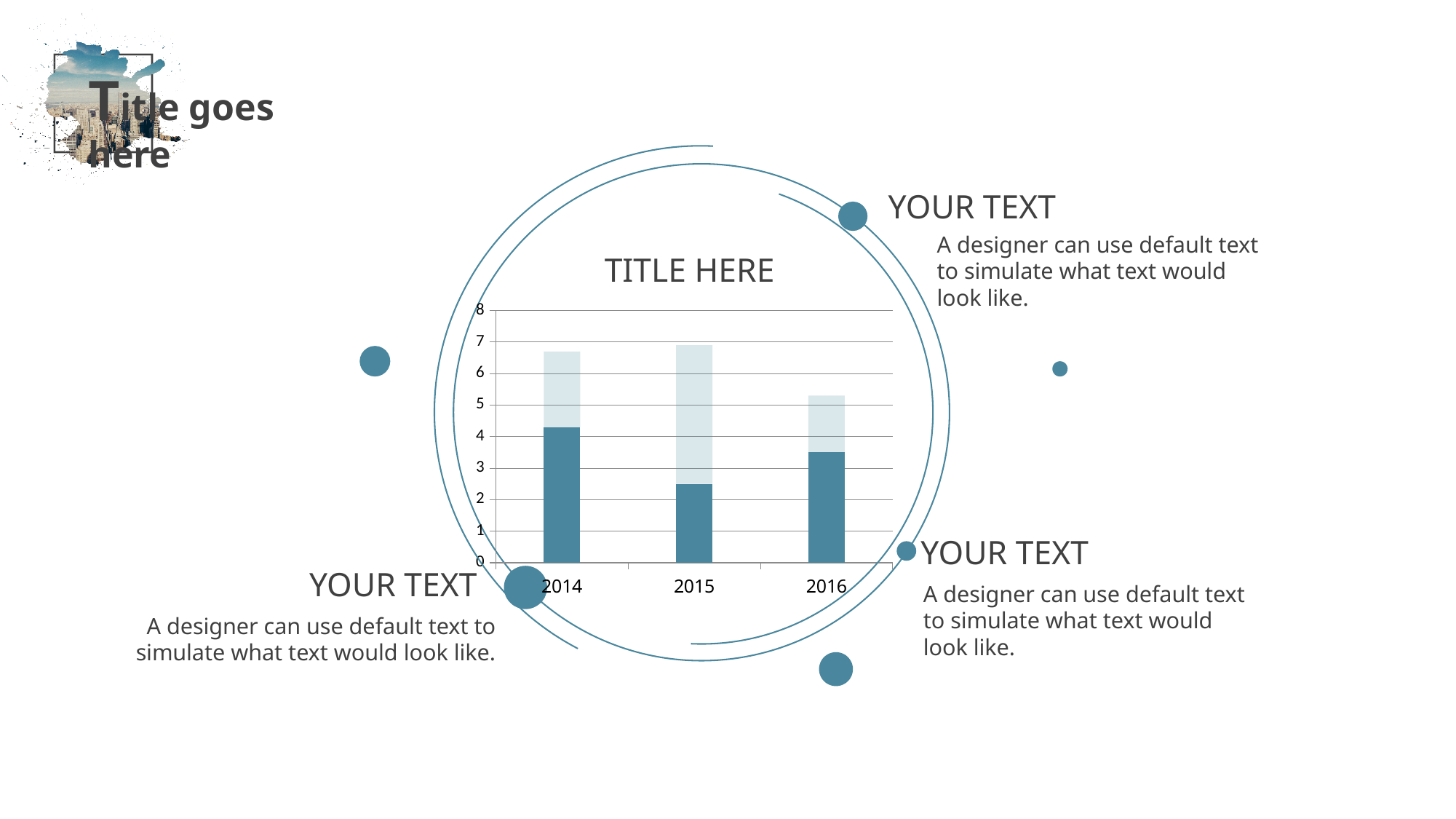
Which year has the tallest dark blue (bottom) segment? 2014 Is the dark blue (bottom) segment larger for 2014 or for 2015? 2014 What kind of chart is shown on the slide? bar chart How many categories are shown on the x axis of the chart? 3 Is the dark blue (bottom) segment for 2016 greater or less than 4? less What is the title of the chart? TITLE HERE Which year has the lowest total stacked bar height? 2016 Is the dark blue (bottom) segment for 2014 greater or less than 4? greater Is the total stacked bar for 2014 greater or less than 6? greater Which year has the shortest dark blue (bottom) segment? 2015